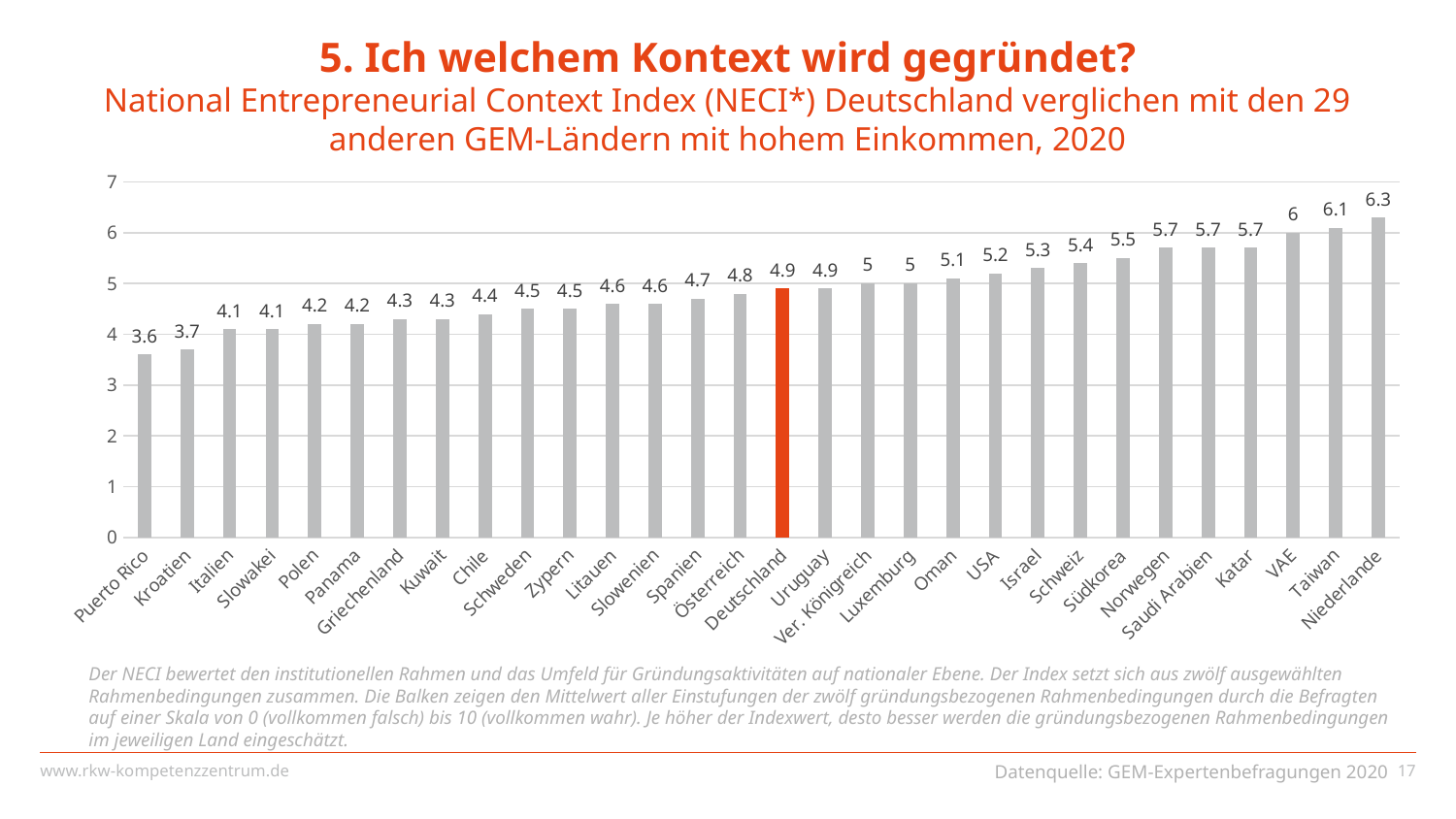
What kind of chart is shown on the slide? bar chart What is the difference between the values for USA and Puerto Rico? 1.6 What is the value shown for Schweiz? 5.4 Which country has the lowest NECI value? Puerto Rico What is the difference between the values for Niederlande and Deutschland? 1.4 How many countries are shown in the chart? 30 What is the value shown for Niederlande? 6.3 Which country has the highest NECI value? Niederlande Which bar is highlighted in a different colour (orange) from the others? Deutschland Is the value for Kroatien greater or less than 4? less What is the NECI value for Deutschland? 4.9 Which has a higher value, Taiwan or Israel? Taiwan